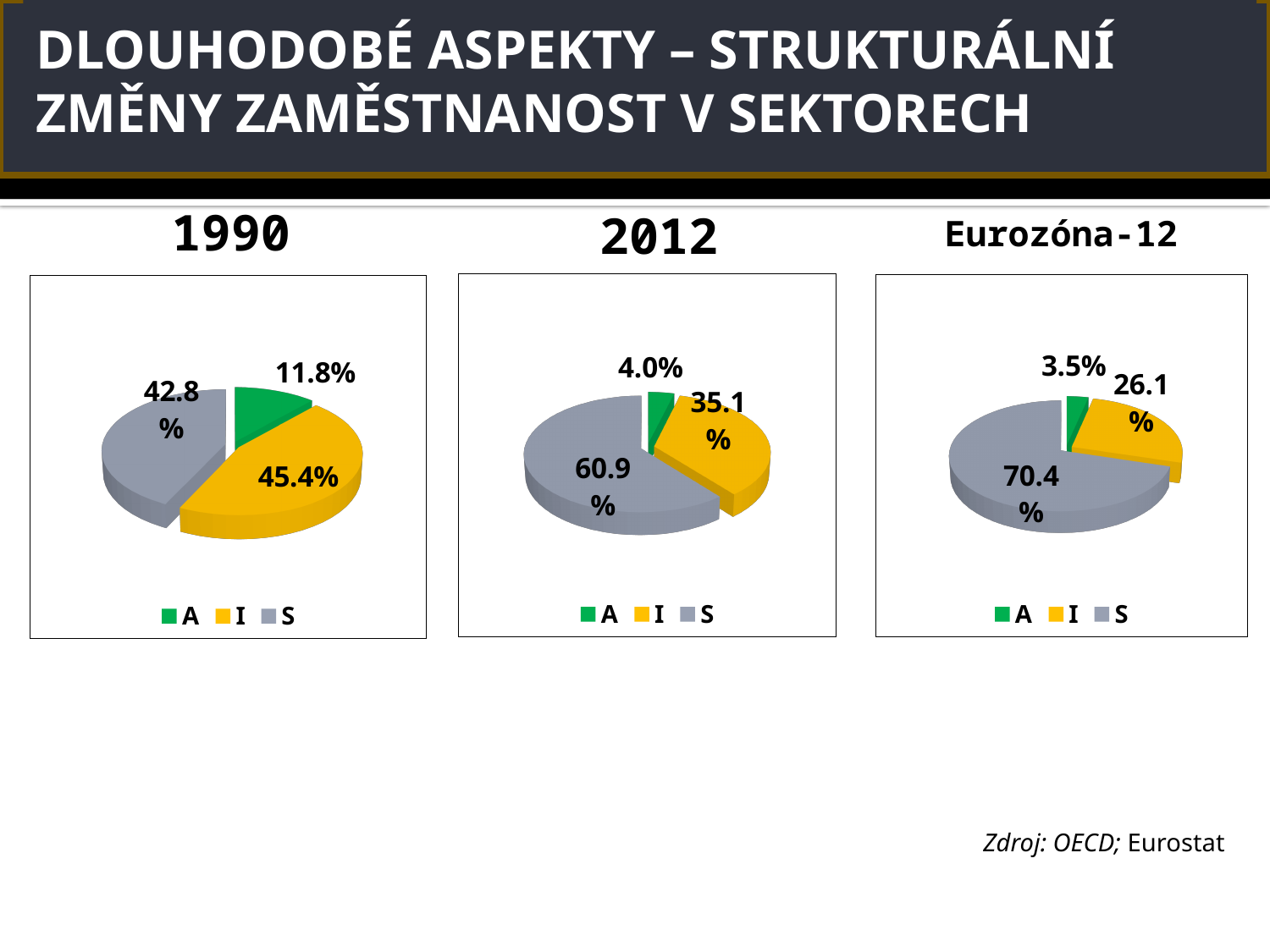
In the Eurozóna-12 chart, which colour represents S in the legend? Grey In the 2012 pie chart, which category has the largest share? S In the 2012 pie chart, what is the value for S? 60.9% In the 1990 pie chart, what is the value for I? 45.4% In the 1990 pie chart, which category has the smallest share? A In the Eurozóna-12 pie chart, what is the value for A? 3.5% What kind of chart is the 1990 chart? Pie chart How many slices does the 2012 pie chart have? 3 In the Eurozóna-12 pie chart, which category has the largest share? S In the 1990 pie chart, which is larger, I or S? I In the Eurozóna-12 pie chart, what is the difference between S and A? 66.9% In the 2012 pie chart, what is the difference between S and I? 25.8%